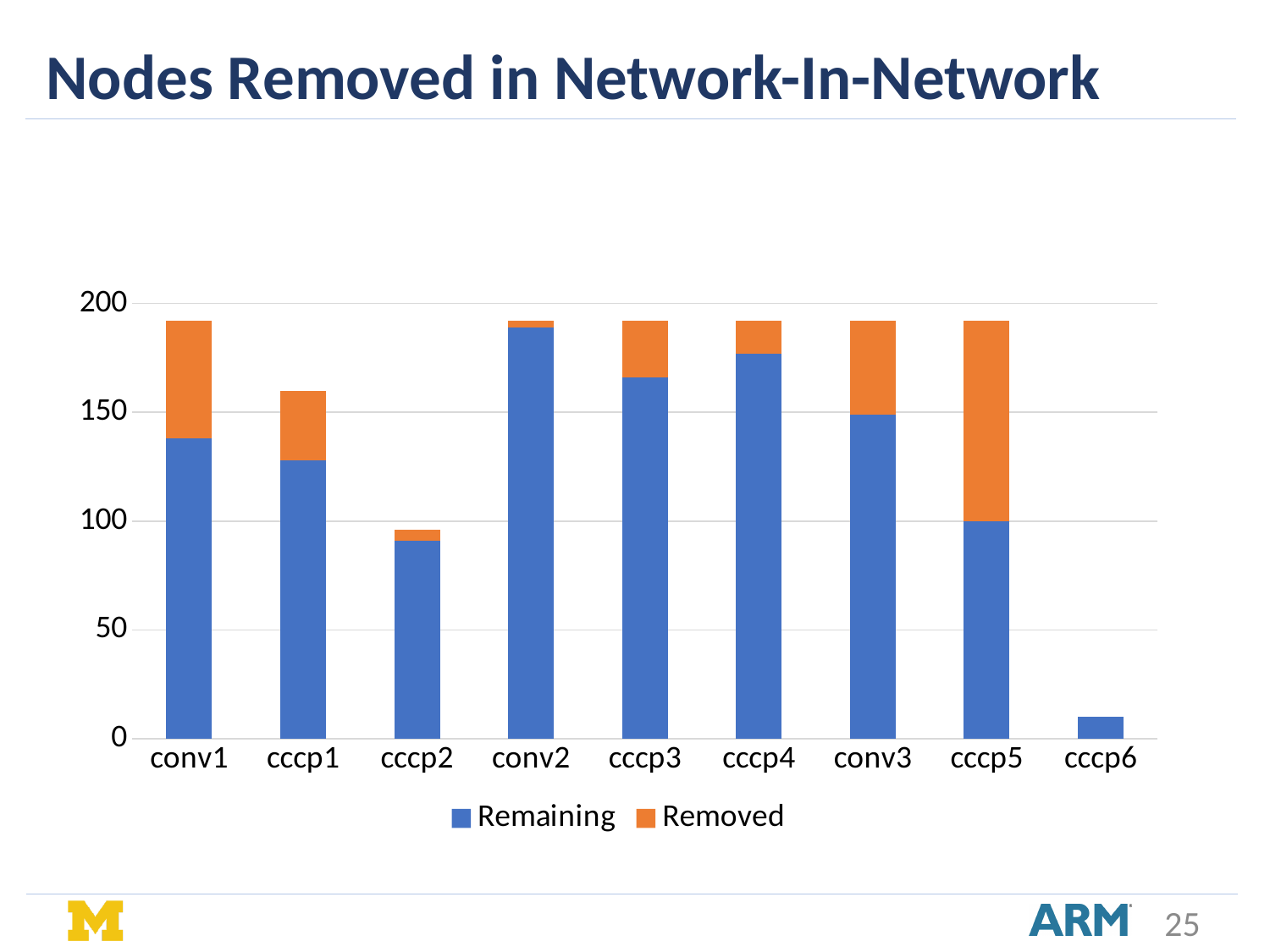
Is the Remaining value for conv1 greater or less than 150? less Is the Remaining value for conv2 greater or less than 150? greater How many series does the legend list? 2 Which category has the largest Removed segment? cccp5 Is the Remaining value for cccp2 greater or less than 100? less Which has the larger Remaining value, cccp3 or conv3? cccp3 How many categories are shown on the x axis of the chart? 9 Which category has the highest Remaining value? conv2 Which category has the lowest Remaining value? cccp6 What colour represents the Removed series in the chart? orange Which has the larger Removed segment, cccp5 or conv1? cccp5 What kind of chart is shown on the slide? stacked bar chart